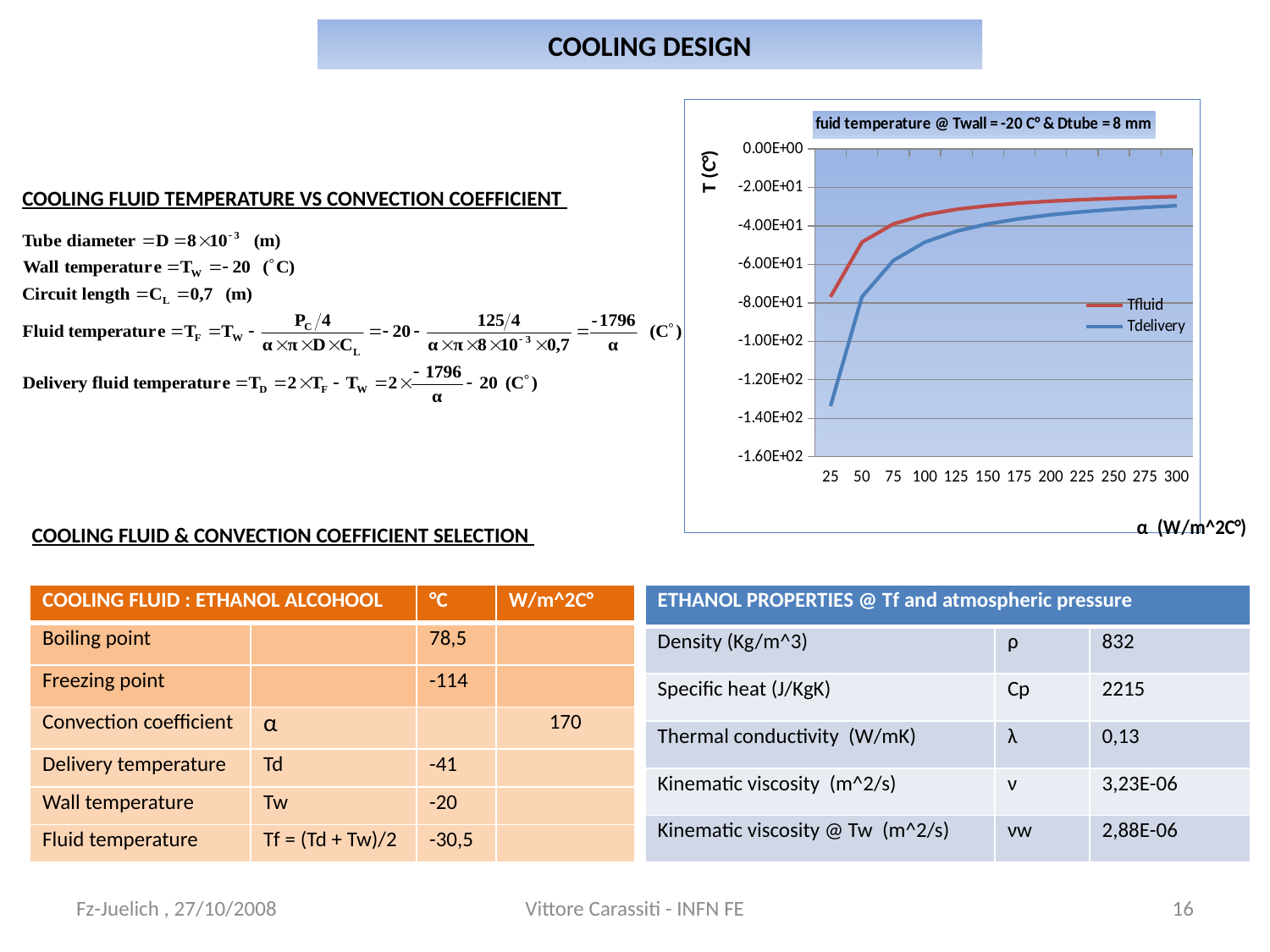
Do the Tfluid values rise or fall as α increases along the x axis? rise How many α values are marked along the x axis of the chart? 12 What are the names of the two series in the chart legend? Tfluid and Tdelivery What is the title of the chart? fuid temperature @ Twall = -20 C° & Dtube = 8 mm Do the Tdelivery values rise or fall as α increases along the x axis? rise Is the Tfluid value at α = 25 greater or less than -1.00E+02? greater Is the Tfluid value at α = 300 greater or less than -4.00E+01? greater Which series and α value gives the lowest point on the chart? Tdelivery at α = 25 What kind of chart is shown on the slide? line chart At α = 25, which series has the larger value, Tfluid or Tdelivery? Tfluid How many series does the chart legend list? 2 Is the Tdelivery value at α = 25 greater or less than -1.20E+02? less